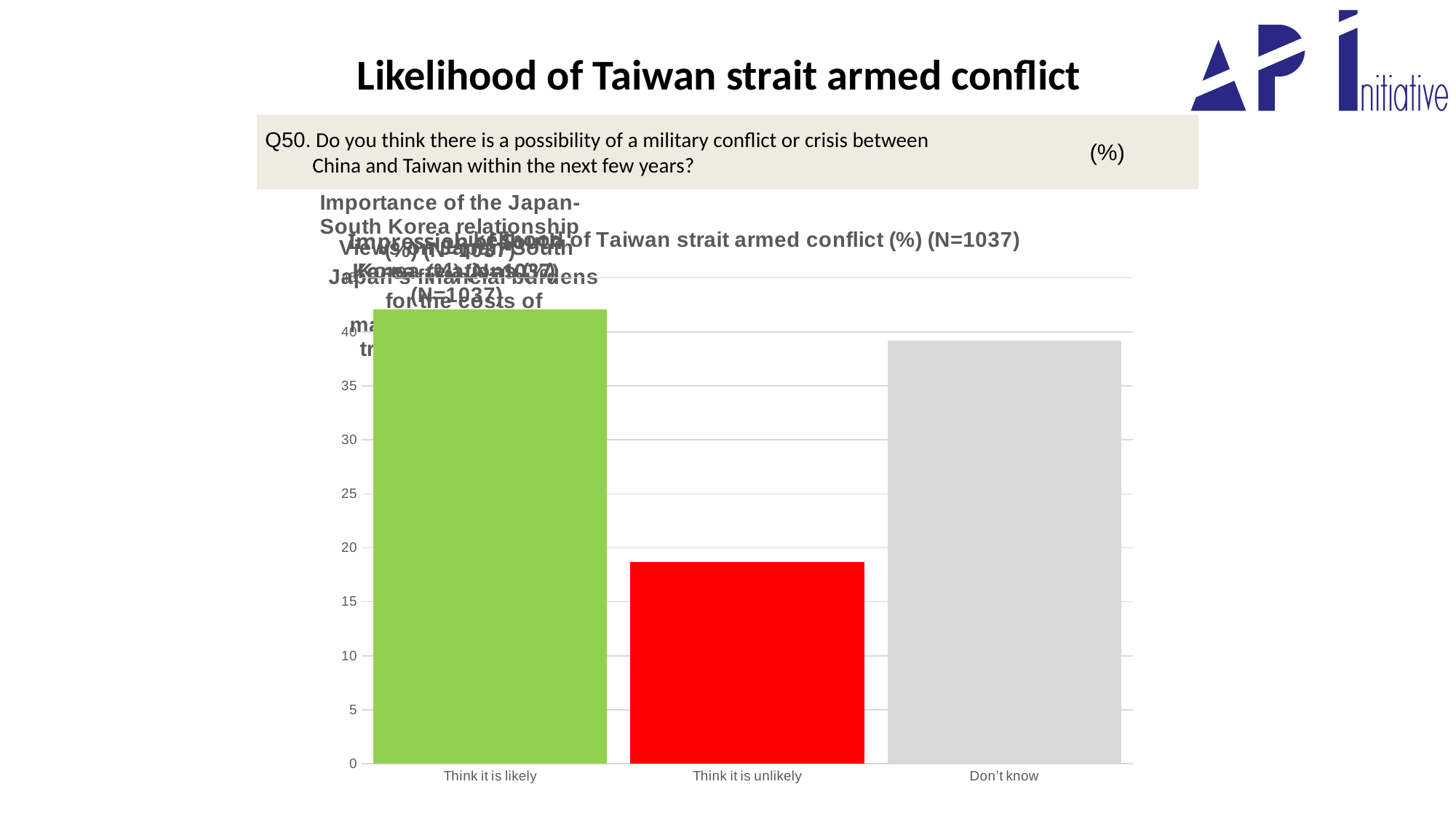
Which category has the lowest value in the chart? Think it is unlikely What kind of chart is shown on the slide? bar chart What sample size (N) is stated in the chart title? N=1037 Is the value for "Don't know" greater or less than 35? greater How many categories are shown on the x axis of the chart? 3 What colour is the bar for "Think it is unlikely"? red Is the value for "Think it is unlikely" greater or less than 15? greater Which category has the highest value in the chart? Think it is likely Which is larger, the value for "Think it is unlikely" or the value for "Don't know"? Don't know Is the value for "Think it is unlikely" greater or less than 20? less